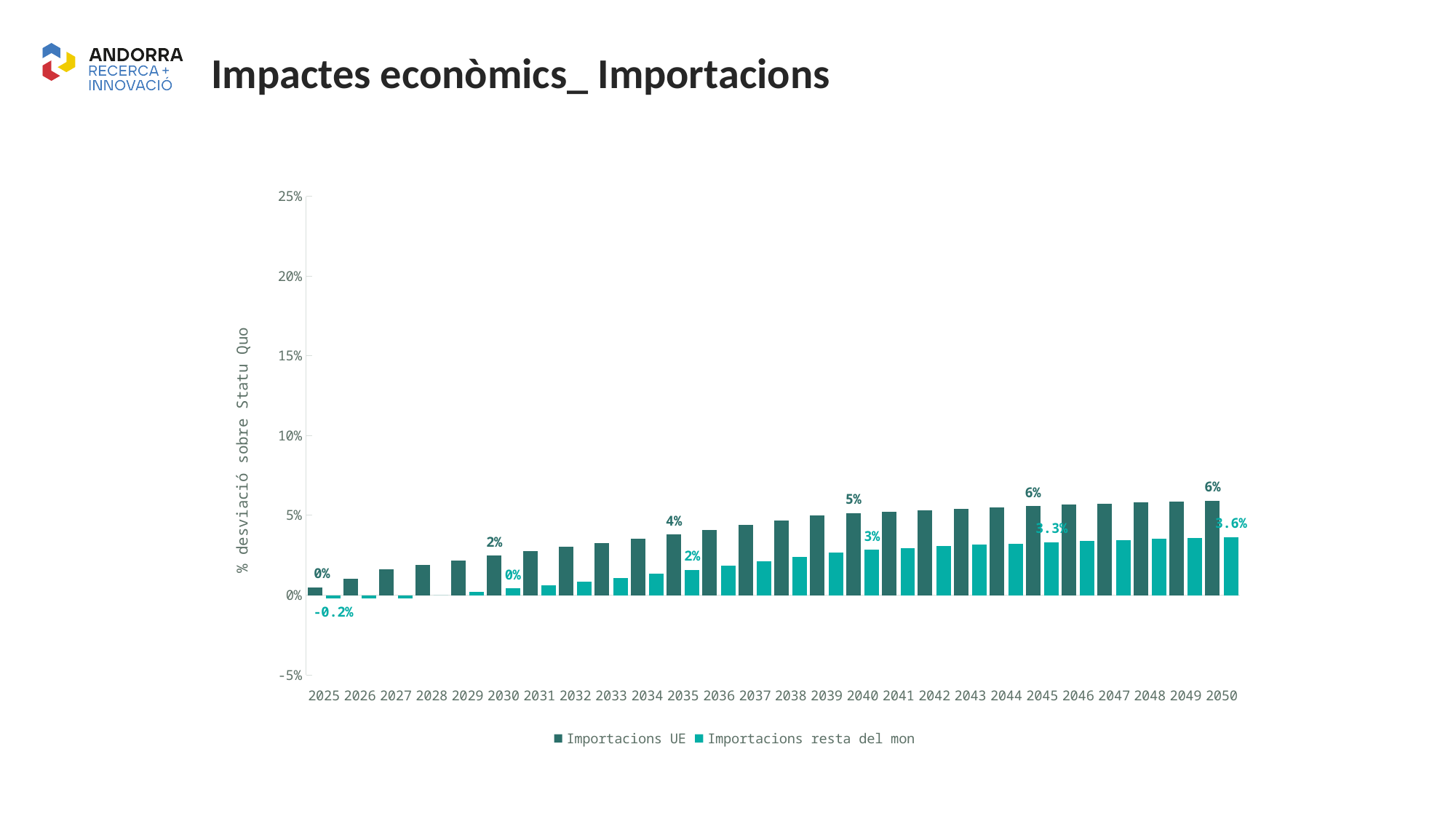
What is the value for Importacions resta del mon in 2045? 3.3% Do the values for Importacions UE rise or fall from 2025 to 2050? Rise What is the value for Importacions UE in 2035? 4% How many series does the legend list? 2 What is the difference between Importacions UE and Importacions resta del mon in 2050? 2.4% In 2040, which series has the larger value, Importacions UE or Importacions resta del mon? Importacions UE What kind of chart is shown on the slide? Bar chart What is the value for Importacions UE in 2050? 6% What is the value for Importacions resta del mon in 2025? -0.2% How many years are shown on the x axis? 26 Is the value for Importacions UE in 2045 greater or less than 10%? less What is the difference between Importacions UE and Importacions resta del mon in 2045? 2.7%